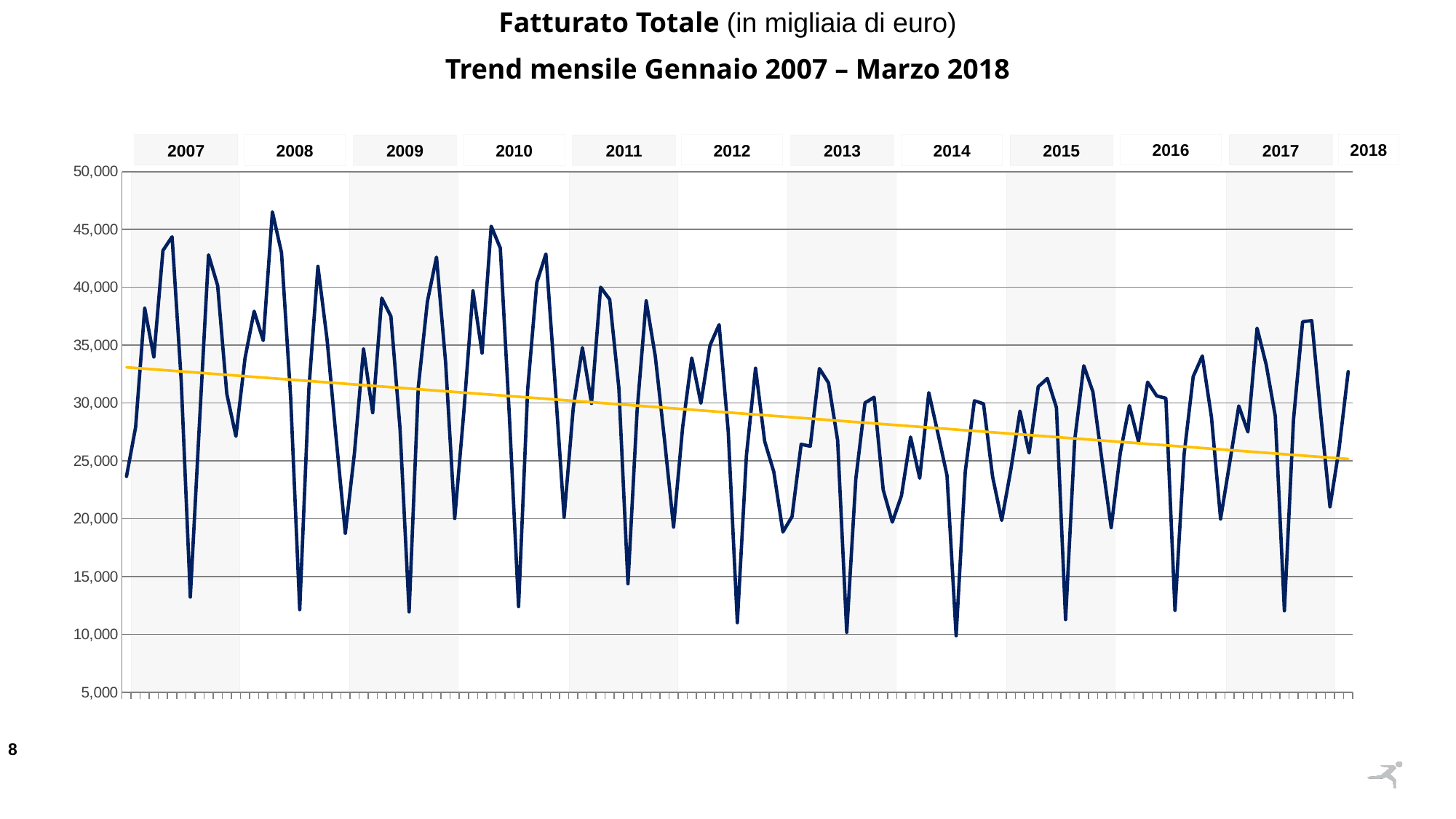
In which year does the dark blue line reach its highest peak? 2008 Is the highest peak of the line in 2008 greater or less than 45,000? greater What kind of chart is shown on the slide? line chart Does the yellow trend line rise or fall from 2007 to 2018? fall Is the highest peak of the line in 2017 greater or less than 40,000? less What is the title of the chart? Fatturato Totale (in migliaia di euro) – Trend mensile Gennaio 2007 – Marzo 2018 Which year has the higher peak on the line, 2008 or 2017? 2008 Is the highest peak of the line in 2016 greater or less than 35,000? less What is the highest value shown on the vertical axis? 50,000 How many year labels are shown along the top of the chart? 12